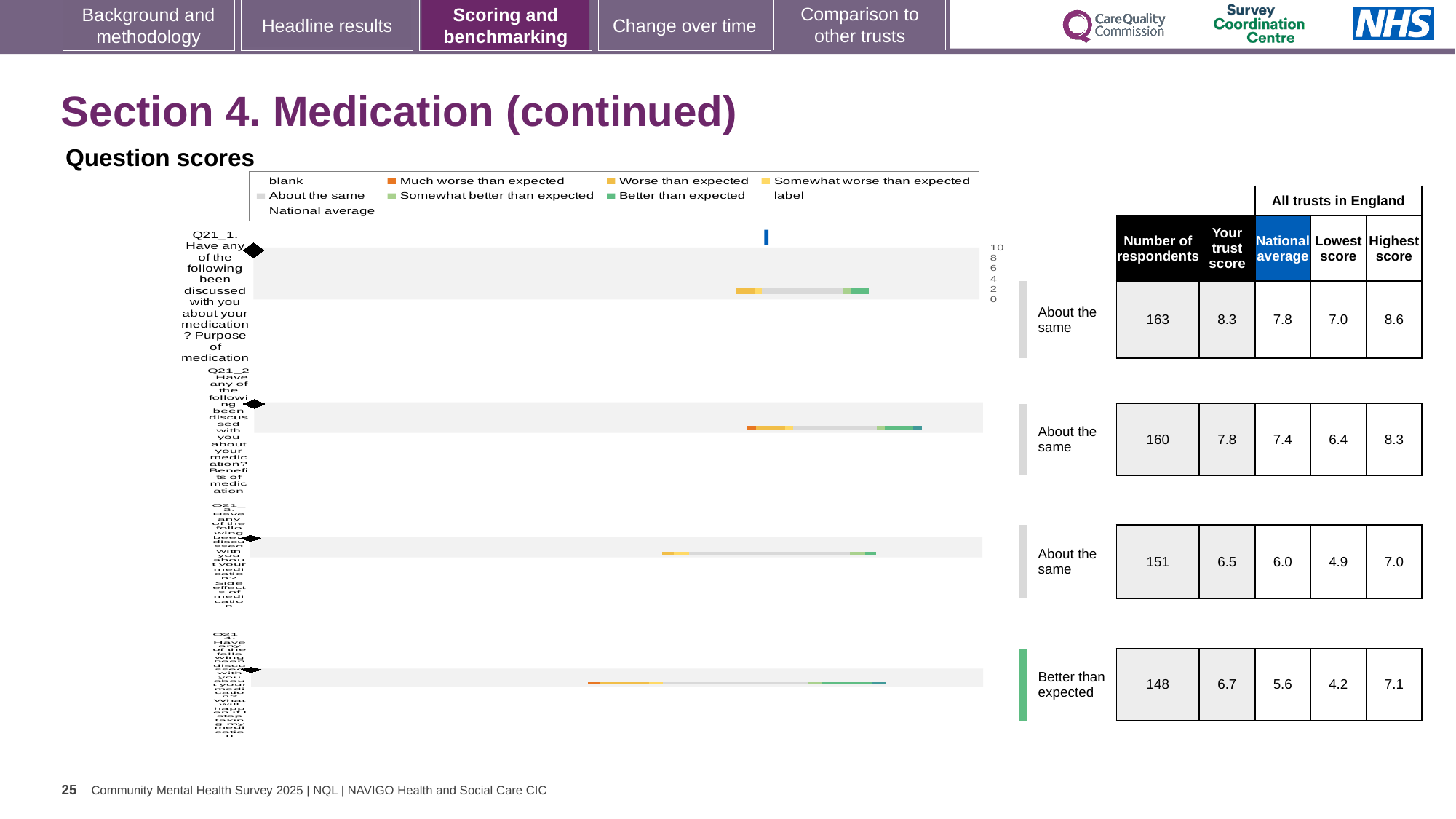
In the table beside the chart, what is the national average for Q21_2 (Benefits of medication)? 7.4 In the table beside the chart, which question has the lowest trust score? Q21_3 (Side effects of medication) How many entries does the legend of the 'Question scores' chart list? 9 Which legend entry in the 'Question scores' chart is shown in orange? Much worse than expected In the table beside the chart, what is the difference between the trust score and the national average for Q21_4? 1.1 How many question bars are plotted in the 'Question scores' chart? 4 In the table beside the chart, which question has the highest trust score? Q21_1 (Purpose of medication) Which legend entry in the 'Question scores' chart is shown in grey? About the same What kind of chart is shown under 'Question scores'? bar chart What is the label of the first (top) bar in the 'Question scores' chart? Q21_1. Have any of the following been discussed with you about your medication? Purpose of medication Which question bar is rated 'Better than expected' in the 'Question scores' chart? Q21_4 In the table beside the chart, what is the trust score for Q21_1 (Purpose of medication)? 8.3